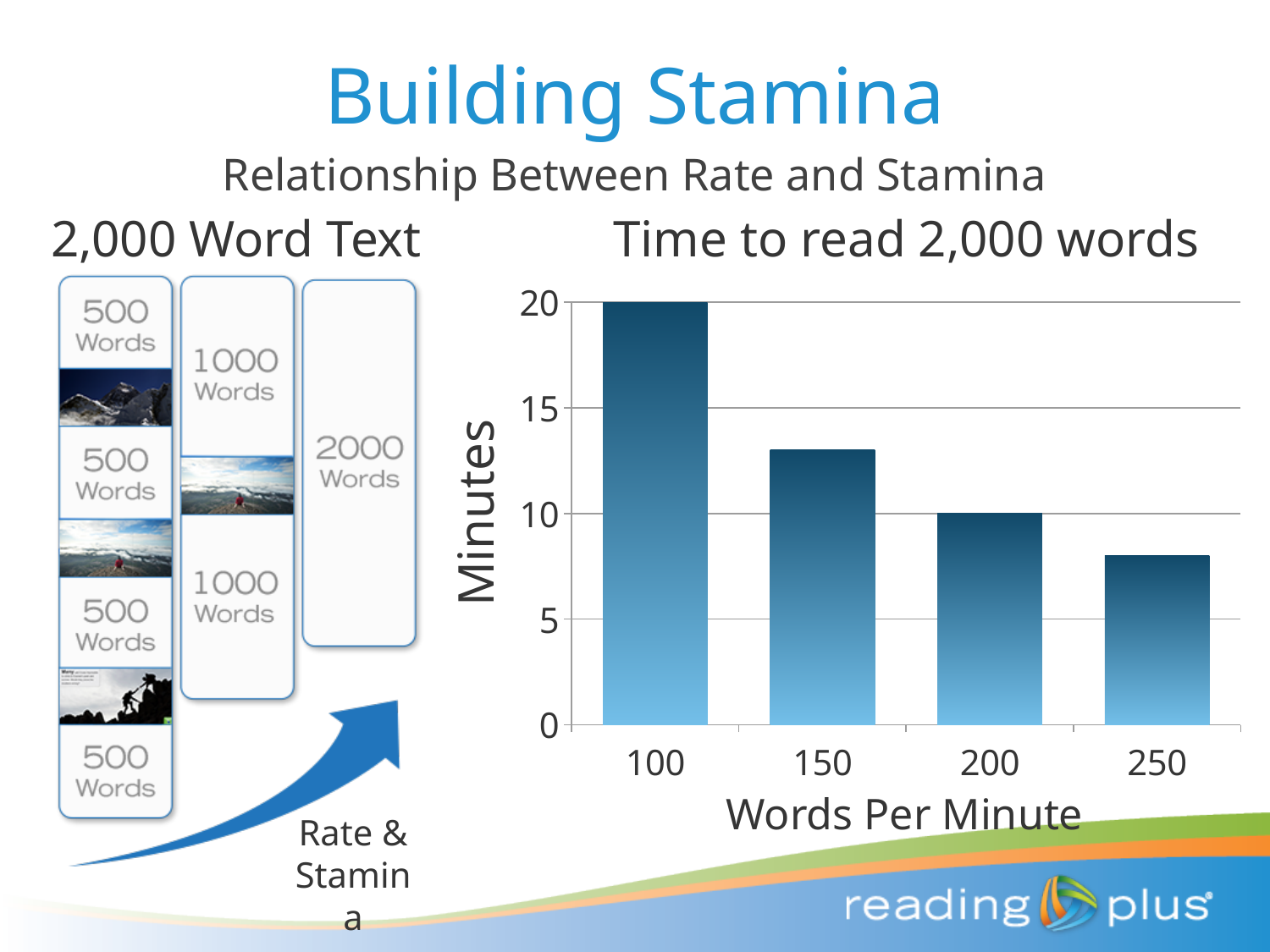
In the chart 'Time to read 2,000 words', how many minutes does it take at 200 words per minute? 10 What is the label on the vertical axis of the chart 'Time to read 2,000 words'? Minutes What type of chart is 'Time to read 2,000 words'? bar chart In the chart 'Time to read 2,000 words', is the value for 250 words per minute greater or less than 10? less In the chart 'Time to read 2,000 words', do the values rise or fall as words per minute increases? fall In the chart 'Time to read 2,000 words', which words-per-minute rate has the highest number of minutes? 100 In the chart 'Time to read 2,000 words', how many minutes does it take at 100 words per minute? 20 How many words-per-minute categories are shown in the chart 'Time to read 2,000 words'? 4 In the chart 'Time to read 2,000 words', which takes more minutes: 150 words per minute or 200 words per minute? 150 In the chart 'Time to read 2,000 words', which words-per-minute rate has the lowest number of minutes? 250 In the chart 'Time to read 2,000 words', is the value for 150 words per minute greater or less than 10? greater In the chart 'Time to read 2,000 words', what is the difference in minutes between reading at 100 words per minute and at 200 words per minute? 10